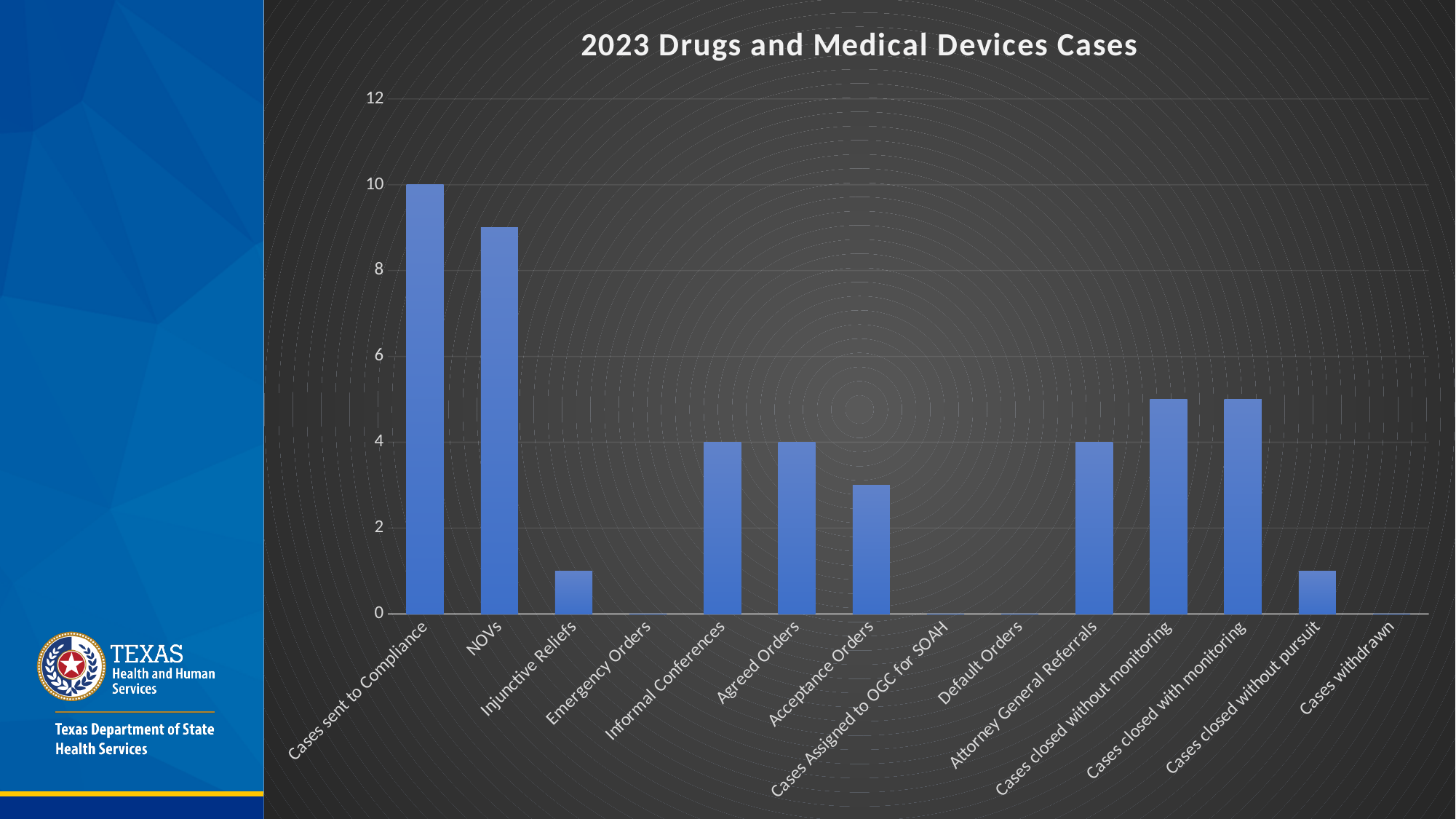
What is the value for Cases sent to Compliance? 10 Is the value for Cases closed without monitoring greater or less than 4? greater What is the title of the chart? 2023 Drugs and Medical Devices Cases Is the value for Injunctive Reliefs greater or less than 2? less Which is larger, NOVs or Acceptance Orders? NOVs What is the value for Informal Conferences? 4 What is the value for Attorney General Referrals? 4 Is the value for Acceptance Orders greater or less than 4? less What is the difference between Cases sent to Compliance and Agreed Orders? 6 How many categories are shown on the x axis? 14 Which category has the highest value? Cases sent to Compliance